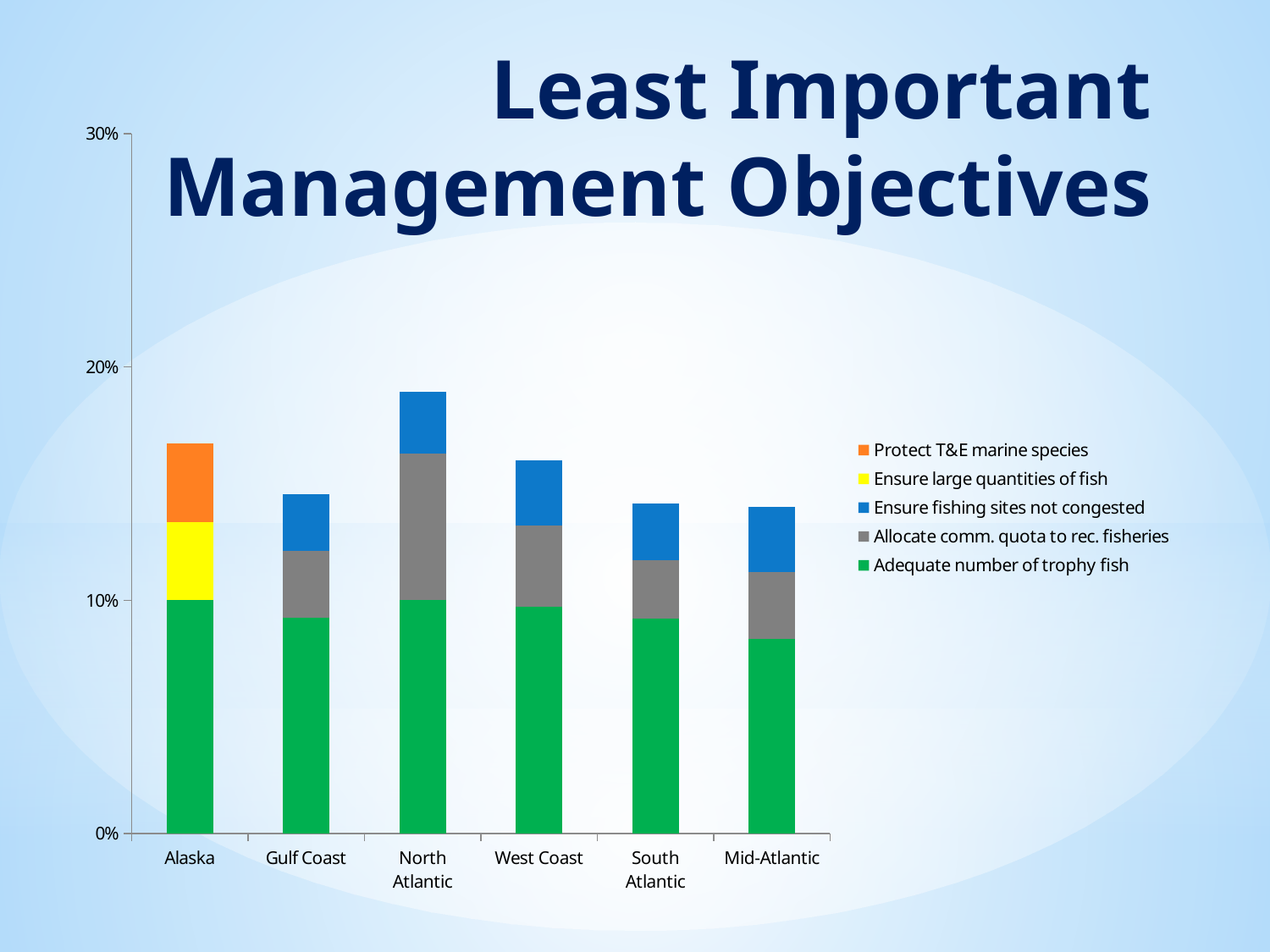
Which region is the only one with a 'Protect T&E marine species' segment in its bar? Alaska What is the title of the chart on the slide? Least Important Management Objectives Which has the larger total stacked bar, North Atlantic or West Coast? North Atlantic Is the total stacked value for Gulf Coast greater or less than 20%? less What kind of chart is shown on the slide? Stacked bar chart How many regions are shown on the x axis of the chart? 6 Which region has the tallest stacked bar overall? North Atlantic Which has the larger total stacked bar, Alaska or Gulf Coast? Alaska Is the total stacked value for Alaska greater or less than 10%? greater Is the total stacked value for North Atlantic greater or less than 20%? less How many series does the chart's legend list? 5